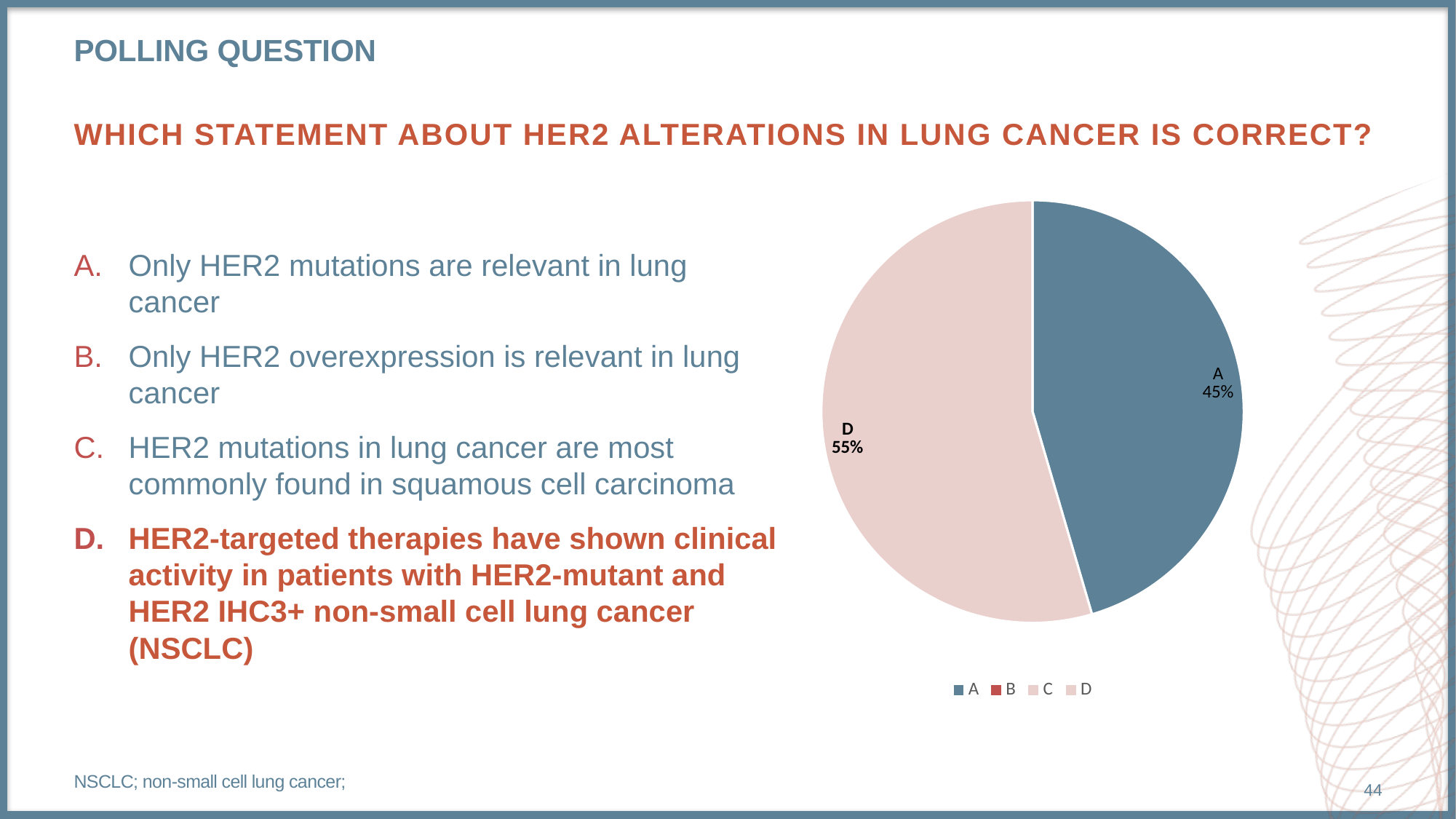
What kind of chart is shown on the slide? pie chart What colour is the slice for option A? blue Is the value for D greater or less than 50%? greater What share of the pie does option A have? 45% How many entries does the legend list? 4 How many slices with data labels are visible in the pie? 2 What share of the pie does option D have? 55% Which is larger, the slice for A or the slice for D? D Which option has the largest slice of the pie? D Is the value for A greater or less than 50%? less What is the difference in percentage points between the D slice and the A slice? 10 Which legend entries are listed, in order? A, B, C, D